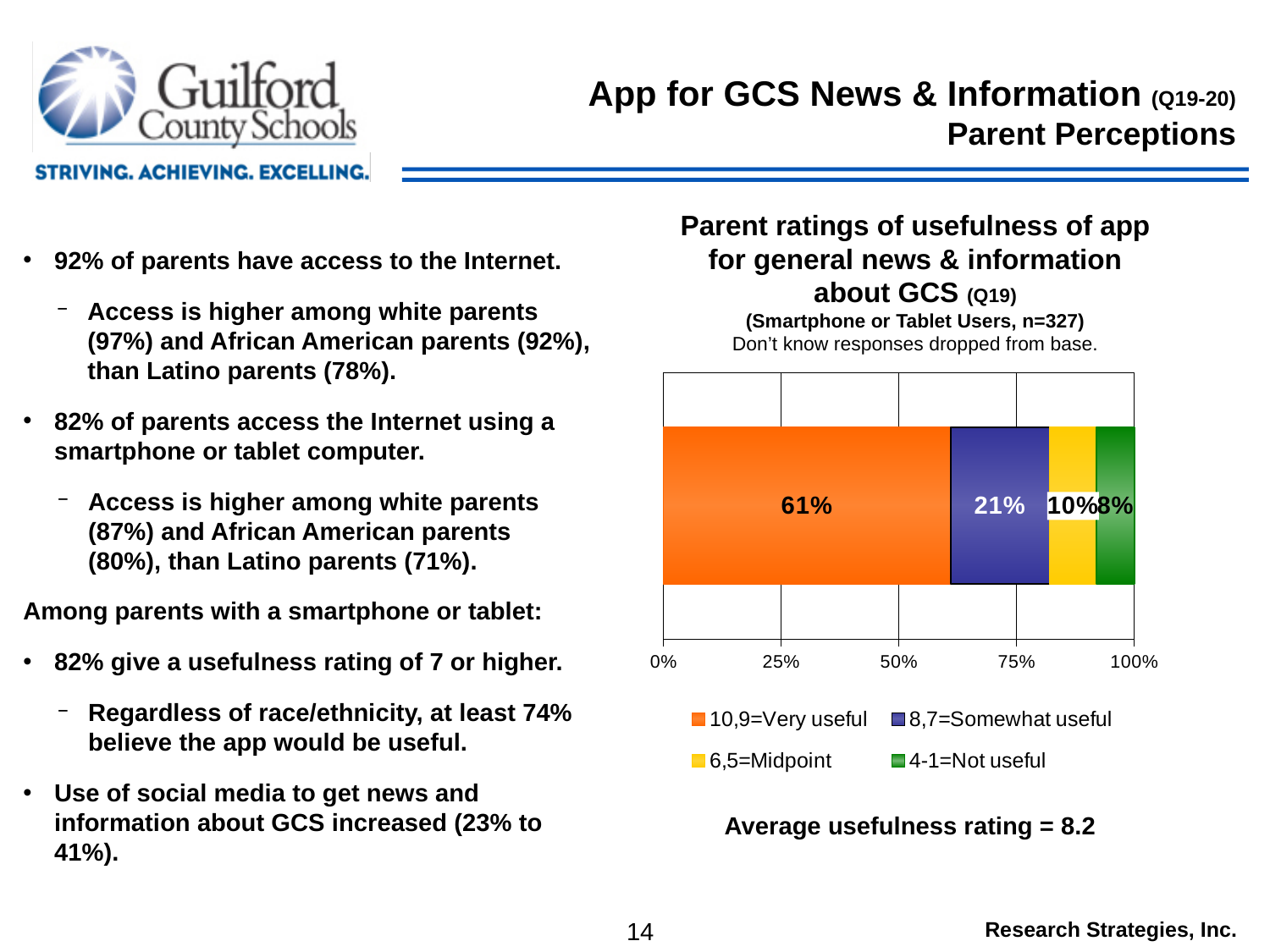
Which rating category has the largest share of parents? 10,9=Very useful What percentage of parents rated the app as Somewhat useful (8,7)? 21% What percentage of parents gave a Midpoint rating (6,5)? 10% What percentage of parents rated the app as Not useful (4-1)? 8% How many series does the legend list? 4 Which is larger, the Midpoint share or the Not useful share? Midpoint What kind of chart is shown on the slide? Stacked bar chart Which rating category has the smallest share of parents? 4-1=Not useful Is the value for Very useful greater or less than 50%? greater What is the difference between the Very useful and Somewhat useful percentages? 40% What percentage of parents rated the app as Very useful (10,9)? 61% What is the sample size (n) shown in the chart subtitle? n=327